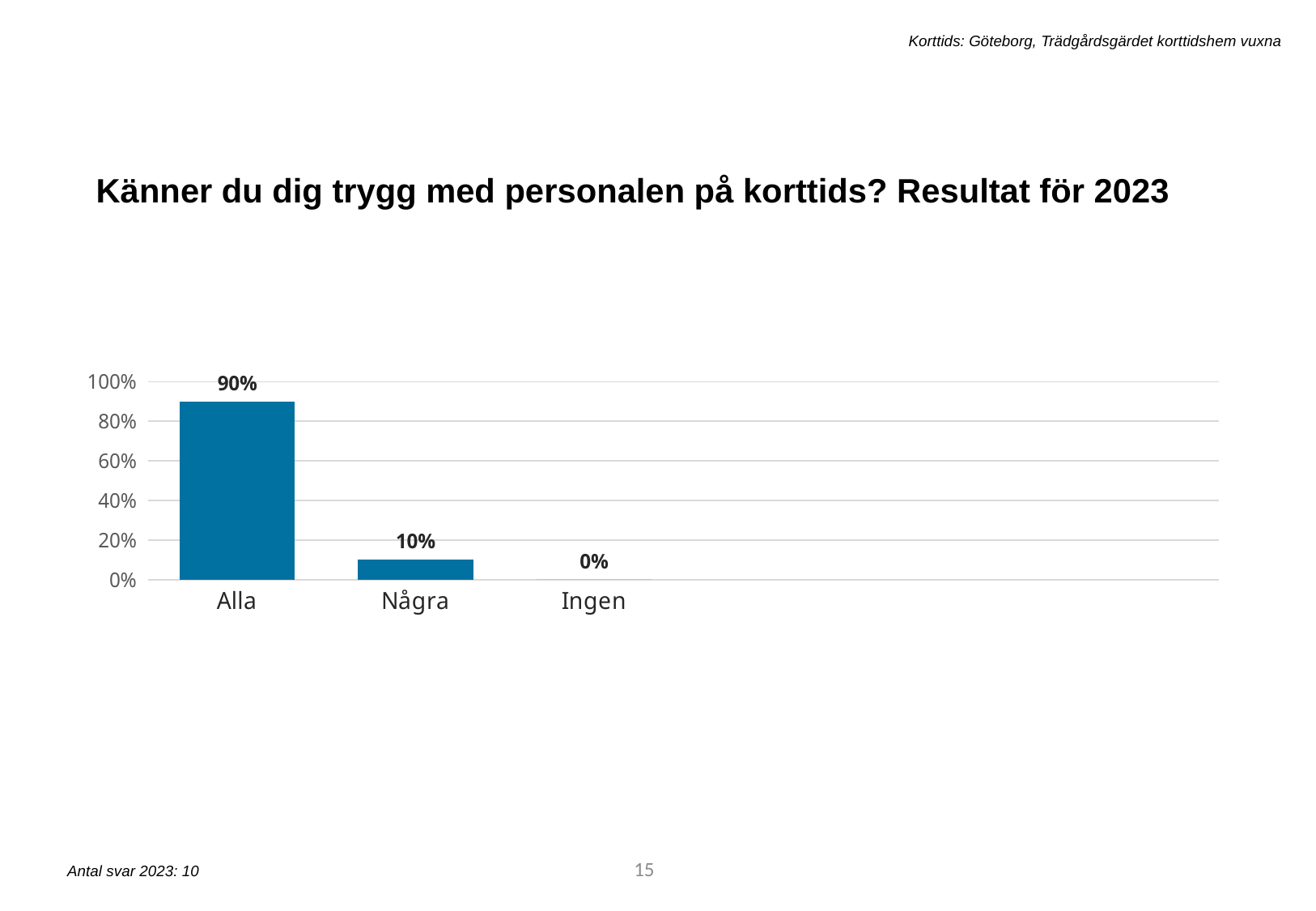
Which category has the lowest value? Ingen What is the difference between the values for Alla and Några? 80% What is the value for Alla? 90% What is the value for Ingen? 0% What is the title of the chart? Känner du dig trygg med personalen på korttids? Resultat för 2023 How many categories are shown on the x axis? 3 Which is larger, the value for Några or the value for Ingen? Några Is the value for Alla greater or less than 80%? greater What is the value for Några? 10% What kind of chart is shown on the slide? Bar chart Which category has the highest value? Alla Do the values rise or fall from left to right along the x axis? Fall